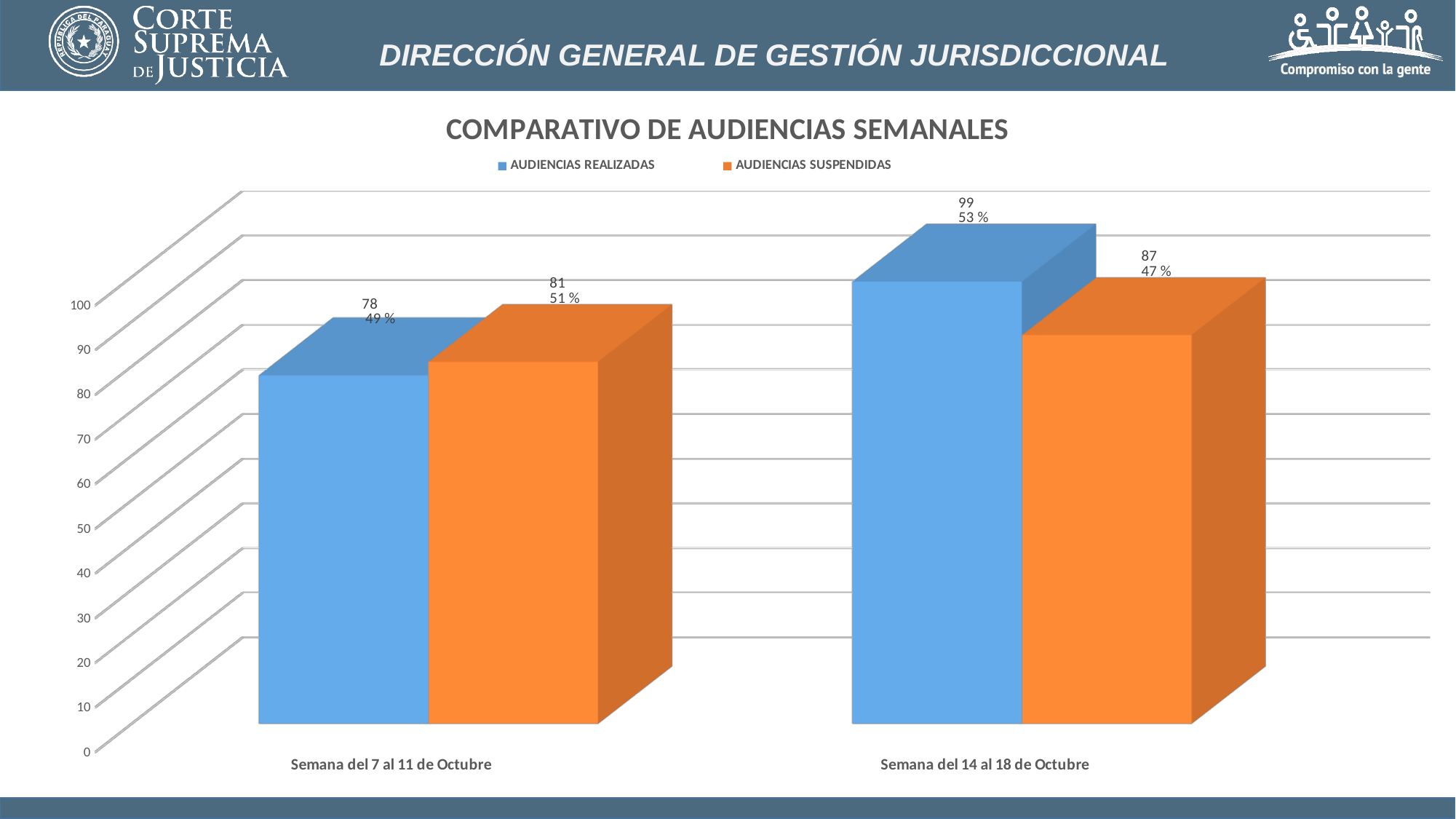
What kind of chart is shown on the slide? Bar chart Which bar has the lowest value in the chart? AUDIENCIAS REALIZADAS, Semana del 7 al 11 de Octubre How many series does the legend list? 2 What percentage label is shown on the AUDIENCIAS REALIZADAS bar for Semana del 14 al 18 de Octubre? 53 % Which is larger for Semana del 7 al 11 de Octubre: AUDIENCIAS REALIZADAS or AUDIENCIAS SUSPENDIDAS? AUDIENCIAS SUSPENDIDAS What is the difference between AUDIENCIAS REALIZADAS and AUDIENCIAS SUSPENDIDAS for Semana del 14 al 18 de Octubre? 12 What is the title of the chart? COMPARATIVO DE AUDIENCIAS SEMANALES What is the value of AUDIENCIAS SUSPENDIDAS for Semana del 14 al 18 de Octubre? 87 What percentage label is shown on the AUDIENCIAS SUSPENDIDAS bar for Semana del 7 al 11 de Octubre? 51 % How many categories (weeks) are shown on the x axis? 2 What is the value of AUDIENCIAS REALIZADAS for Semana del 7 al 11 de Octubre? 78 Which bar has the highest value in the chart? AUDIENCIAS REALIZADAS, Semana del 14 al 18 de Octubre